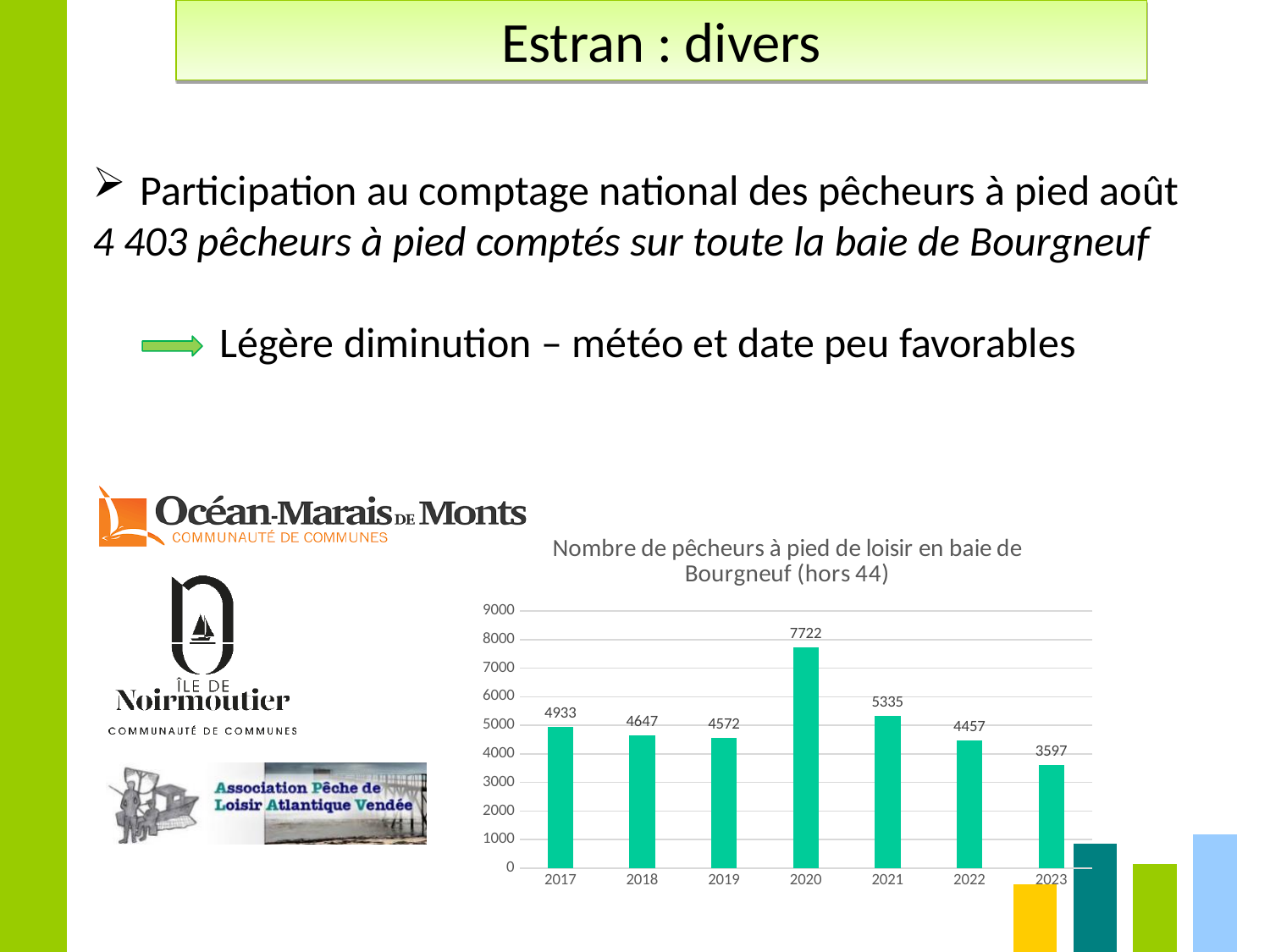
Which year has the lowest value in the chart? 2023 Which is larger, the value for 2018 or the value for 2019? 2018 Is the value for 2021 greater or less than 5000? greater What is the difference between the values for 2022 and 2023? 860 What is the value for 2017 in the chart? 4933 Which year has the highest value in the chart? 2020 What is the title of the chart? Nombre de pêcheurs à pied de loisir en baie de Bourgneuf (hors 44) What is the value for 2023 in the chart? 3597 What kind of chart is shown on the slide? bar chart What is the value for 2020 in the chart? 7722 How many years are shown on the x axis of the chart? 7 What is the difference between the values for 2020 and 2021? 2387